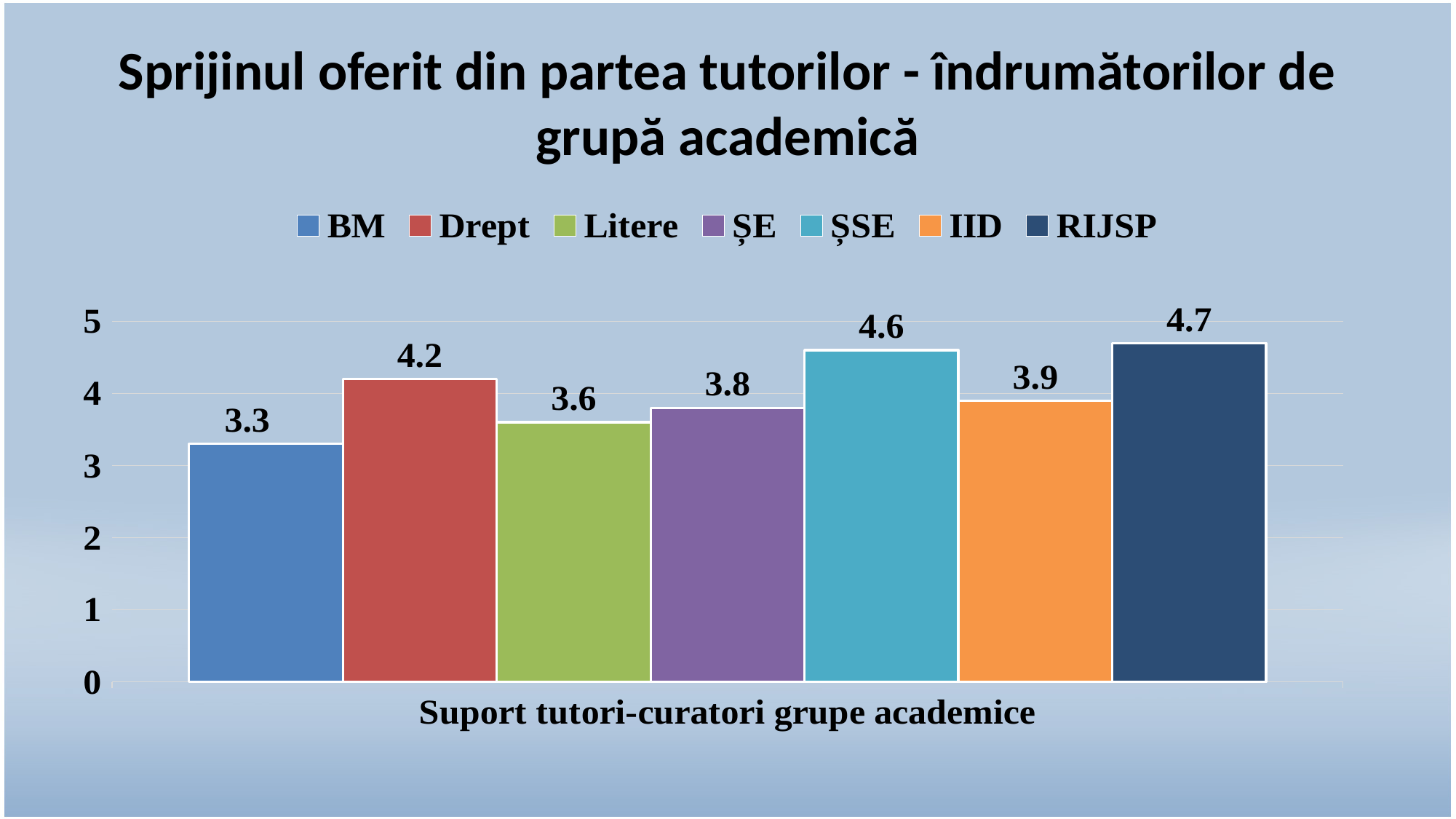
What kind of chart is shown on the slide? bar chart What is the difference between the values for RIJSP and BM? 1.4 What is the value for ȘSE? 4.6 Which series has the highest value? RIJSP What is the value for Drept? 4.2 What is the difference between the values for Drept and Litere? 0.6 What is the value for IID? 3.9 How many series does the legend list? 7 Which series has the lowest value? BM Is the value for Litere greater or less than 4? less Which is larger, the value for ȘE or the value for IID? IID What is the label shown on the x axis of the chart? Suport tutori-curatori grupe academice